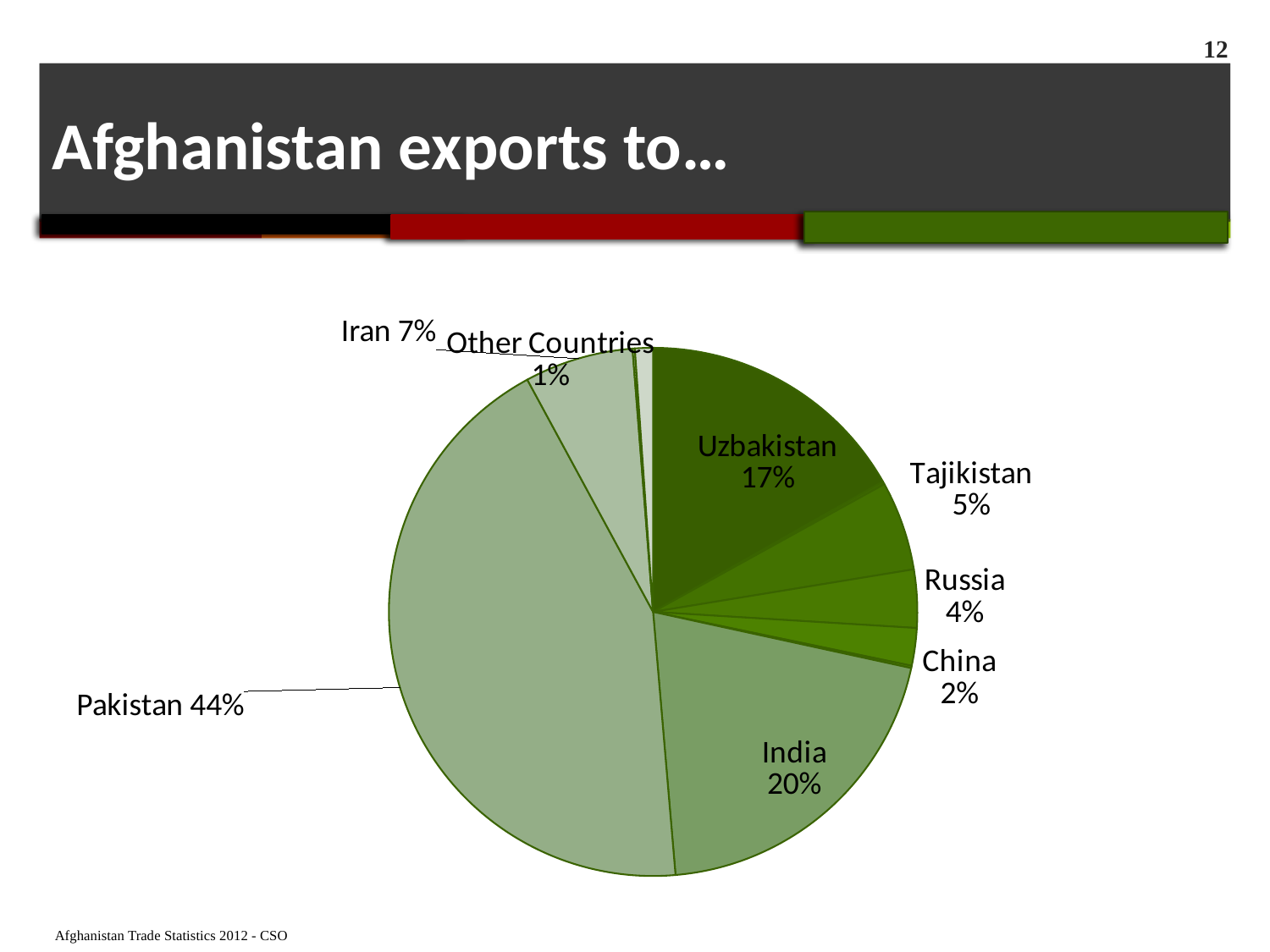
What share of Afghanistan's exports goes to Pakistan? 44% What percentage is shown for Uzbakistan? 17% What percentage is shown for Tajikistan? 5% What type of chart is shown on the slide? Pie chart How many percentage points larger is Pakistan's share than India's share? 24 How many slices does the pie chart have? 11 What percentage is shown for Other Countries? 1% Which country receives the largest share of Afghanistan's exports? Pakistan What share of Afghanistan's exports goes to India? 20% Which has a larger share of exports, Iran or China? Iran What percentage is shown for Russia? 4%